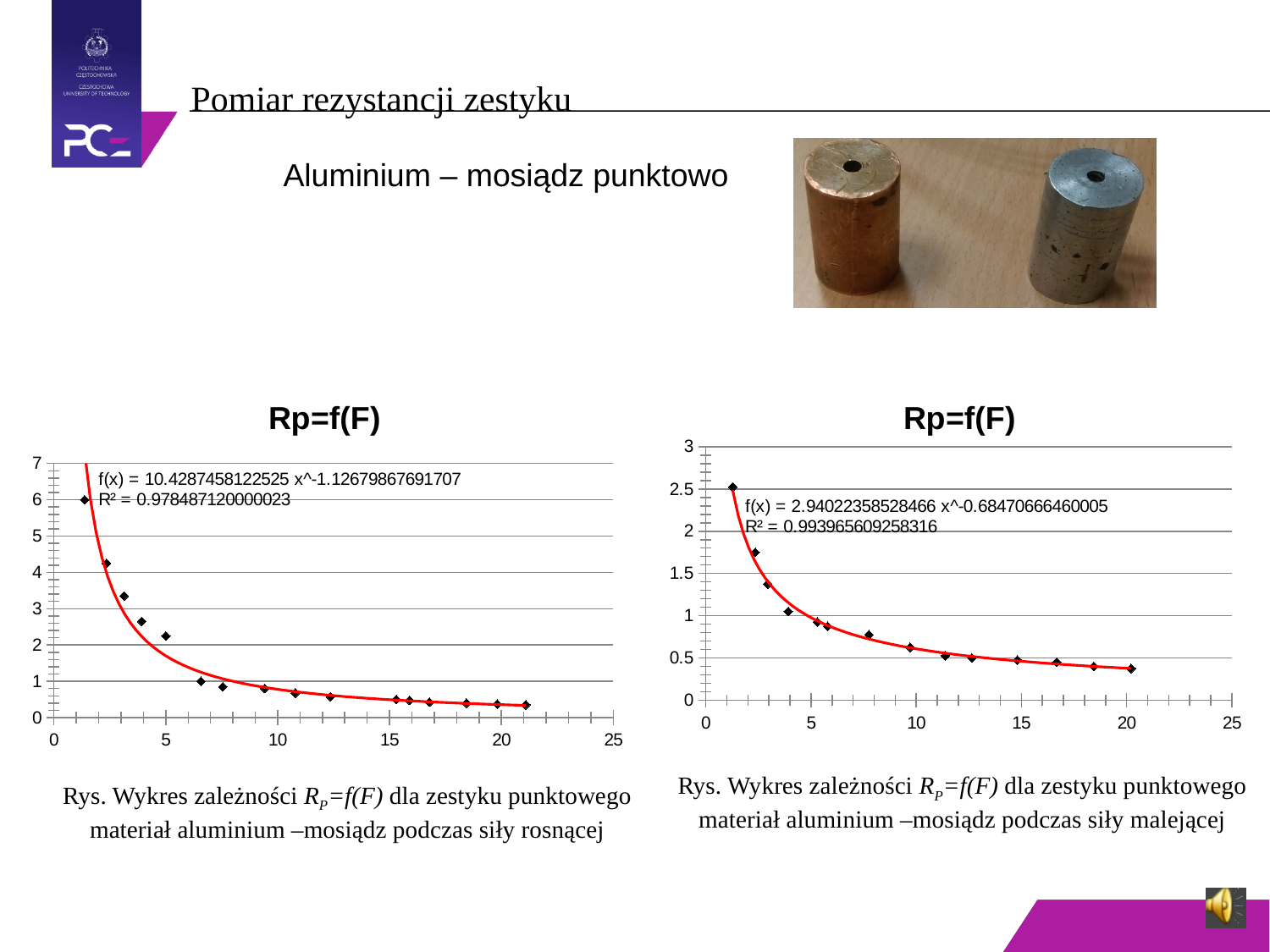
In the right chart (Rp=f(F), siły malejącej), do the plotted values rise or fall as F increases along the x axis? fall What type of chart is the left chart titled Rp=f(F)? scatter chart What is the maximum value shown on the y axis of the left chart? 7 In the left chart (Rp=f(F), siły rosnącej), do the plotted values rise or fall as F increases along the x axis? fall In the right chart, is the value of the data point at about F=10 greater or less than 1? less In the right chart, is the value of the first (leftmost) data point greater or less than 2? greater In the left chart, which data point has the highest Rp value, the leftmost or the rightmost? the leftmost What is the maximum value shown on the y axis of the right chart? 3 What is the R² value shown on the right chart? 0.993965609258316 What is the R² value shown on the left chart? 0.978487120000023 In the left chart, is the value of the first (leftmost) data point greater or less than 5? greater